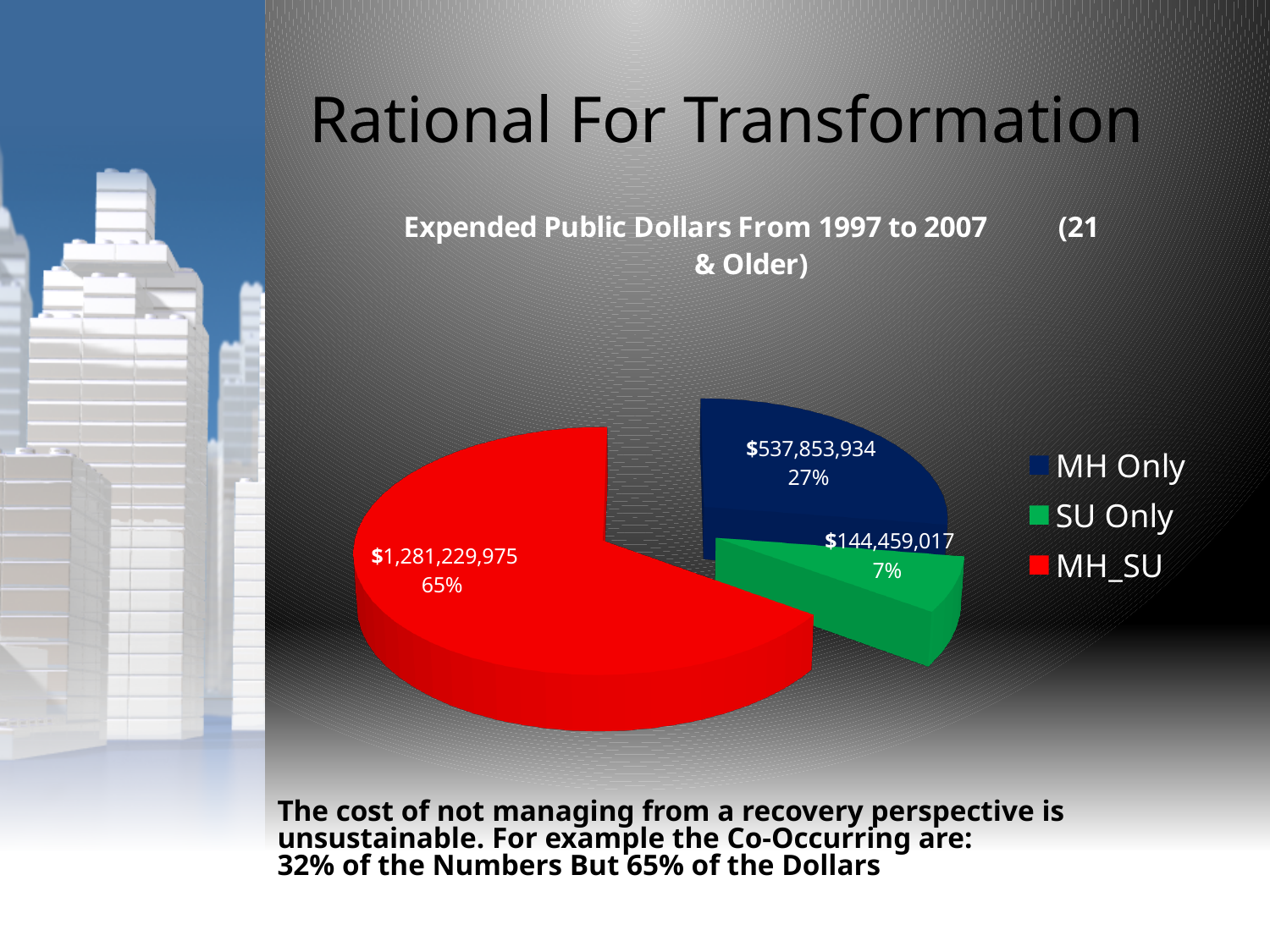
How many slices does the pie chart have? 3 What kind of chart is shown on the slide? pie chart What is the dollar value for SU Only? $144,459,017 What is the title of the chart? Expended Public Dollars From 1997 to 2007 (21 & Older) Which category has the smallest slice? SU Only What share of the pie does MH_SU represent? 65% What share of the pie does SU Only represent? 7% How many entries does the legend list? 3 What is the dollar value for MH Only? $537,853,934 Which category has the largest slice? MH_SU What is the dollar value for MH_SU? $1,281,229,975 Which is larger, MH Only or SU Only? MH Only